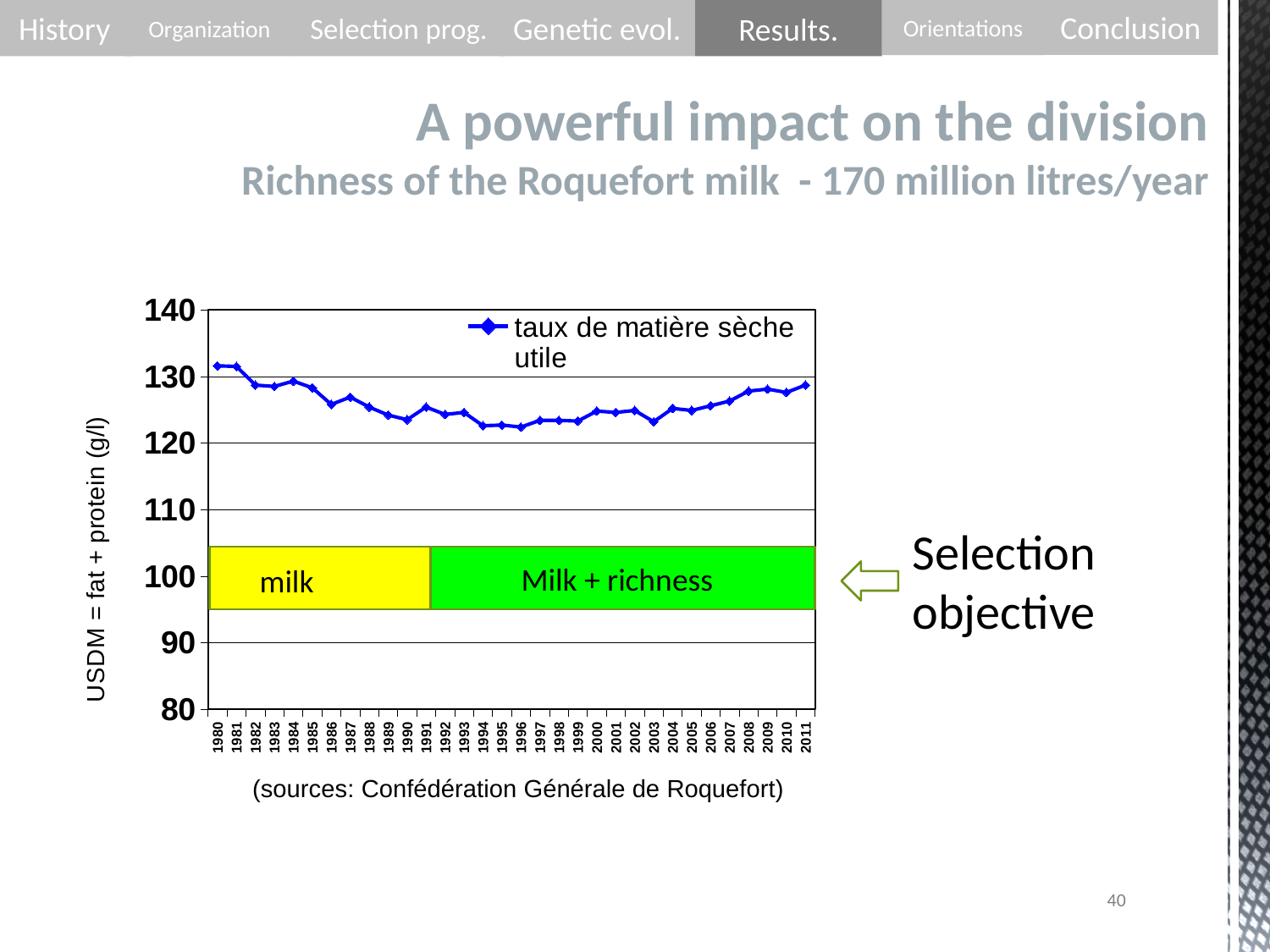
How many years are plotted along the x axis of the chart? 32 Is the value for 1980 greater or less than 130? greater How many series does the chart legend list? 1 Is the value for 1994 greater or less than 130? less Do the values rise or fall from 1980 to 1994? fall Which year has the larger value, 1980 or 1994? 1980 What is the label on the vertical axis of the chart? USDM = fat + protein (g/l) Which year has the larger value, 1996 or 2011? 2011 Is the value for 1996 greater or less than 120? greater What is the name of the series shown in the chart legend? taux de matière sèche utile What kind of chart is shown on the slide? line chart